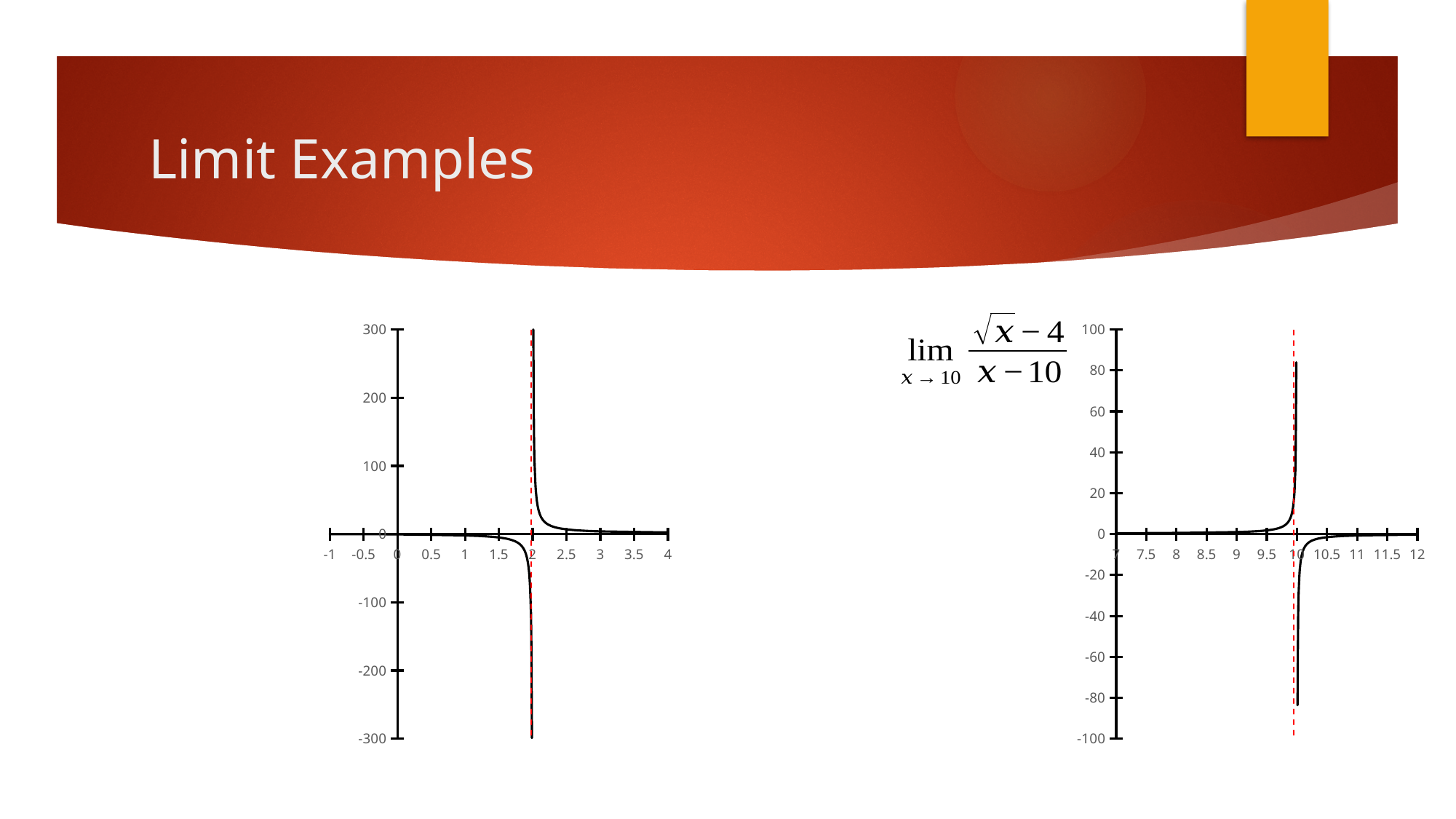
On the left chart, what is the highest value labelled on the y axis? 300 On the right chart, is the value of the curve at x = 11 greater or less than 20? less On the right chart, what is the rightmost x-axis tick label? 12 On the left chart, is the value of the curve at x = 3 greater or less than 100? less On the left chart, as x increases from 2.5 to 4, does the curve rise or fall? fall What kind of chart is the left chart? line chart On the right chart, as x approaches 10 from the left, does the curve go up or down? up On the left chart, what is the leftmost x-axis tick label? -1 On the right chart, at what x value is the dashed red vertical line drawn? 10 On the right chart, what is the lowest value labelled on the y axis? -100 On the right chart, what is the leftmost x-axis tick label? 7 On the left chart, at what x value is the dashed red vertical line drawn? 2